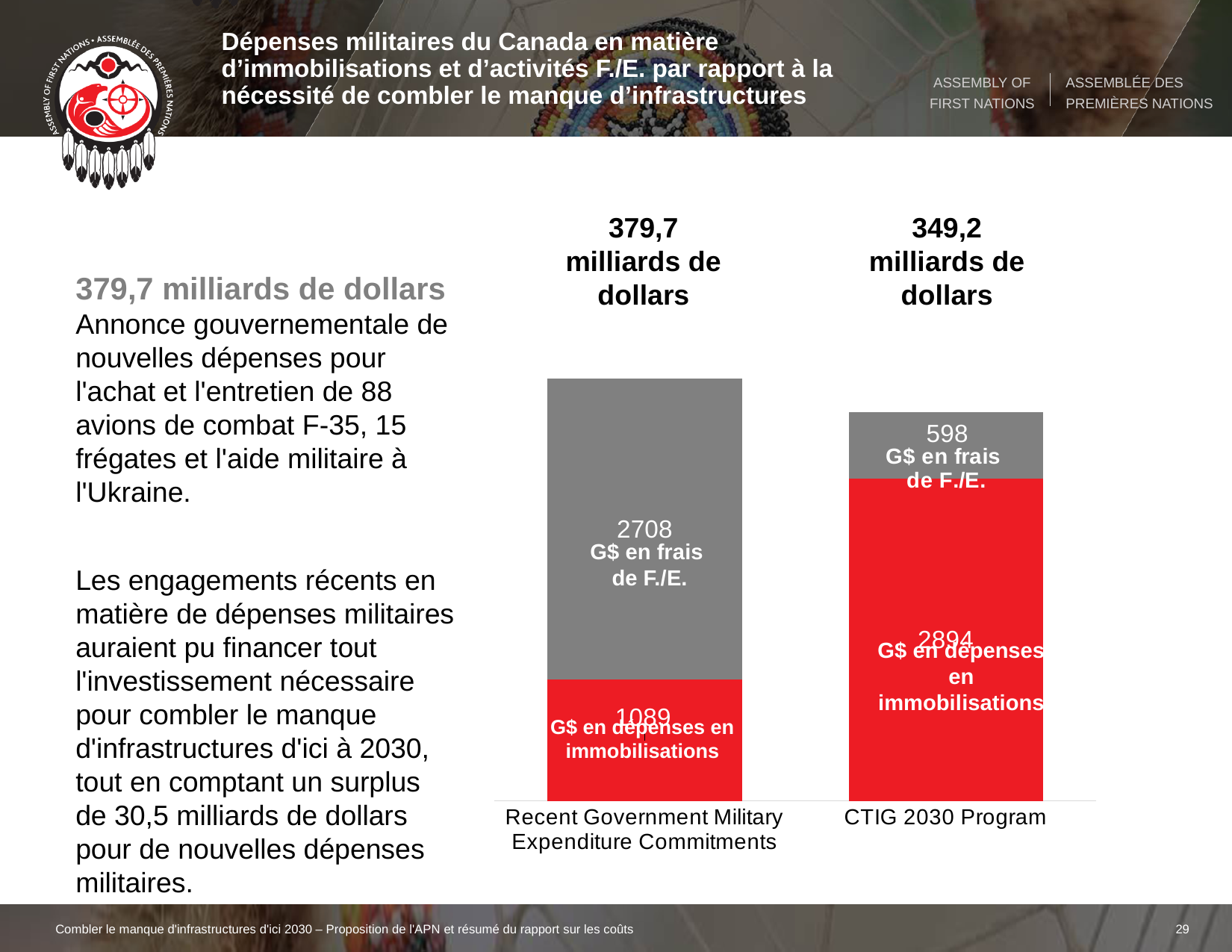
What is the value of the 'G$ en frais de F./E.' segment for Recent Government Military Expenditure Commitments? 2708 How many categories are shown along the x axis of the chart? 2 What total is printed above the bar for CTIG 2030 Program? 349,2 milliards de dollars What kind of chart is shown on the slide? Stacked bar chart What is the difference between the 'G$ en dépenses en immobilisations' values for CTIG 2030 Program and Recent Government Military Expenditure Commitments? 1805 What is the value of the 'G$ en frais de F./E.' segment for CTIG 2030 Program? 598 What total is printed above the bar for Recent Government Military Expenditure Commitments? 379,7 milliards de dollars Which category has the larger 'G$ en frais de F./E.' segment? Recent Government Military Expenditure Commitments What is the value of the 'G$ en dépenses en immobilisations' segment for CTIG 2030 Program? 2894 What colour is used for the 'G$ en dépenses en immobilisations' segments in the chart? Red What is the difference between the 'G$ en frais de F./E.' values for Recent Government Military Expenditure Commitments and CTIG 2030 Program? 2110 What is the value of the 'G$ en dépenses en immobilisations' segment for Recent Government Military Expenditure Commitments? 1089